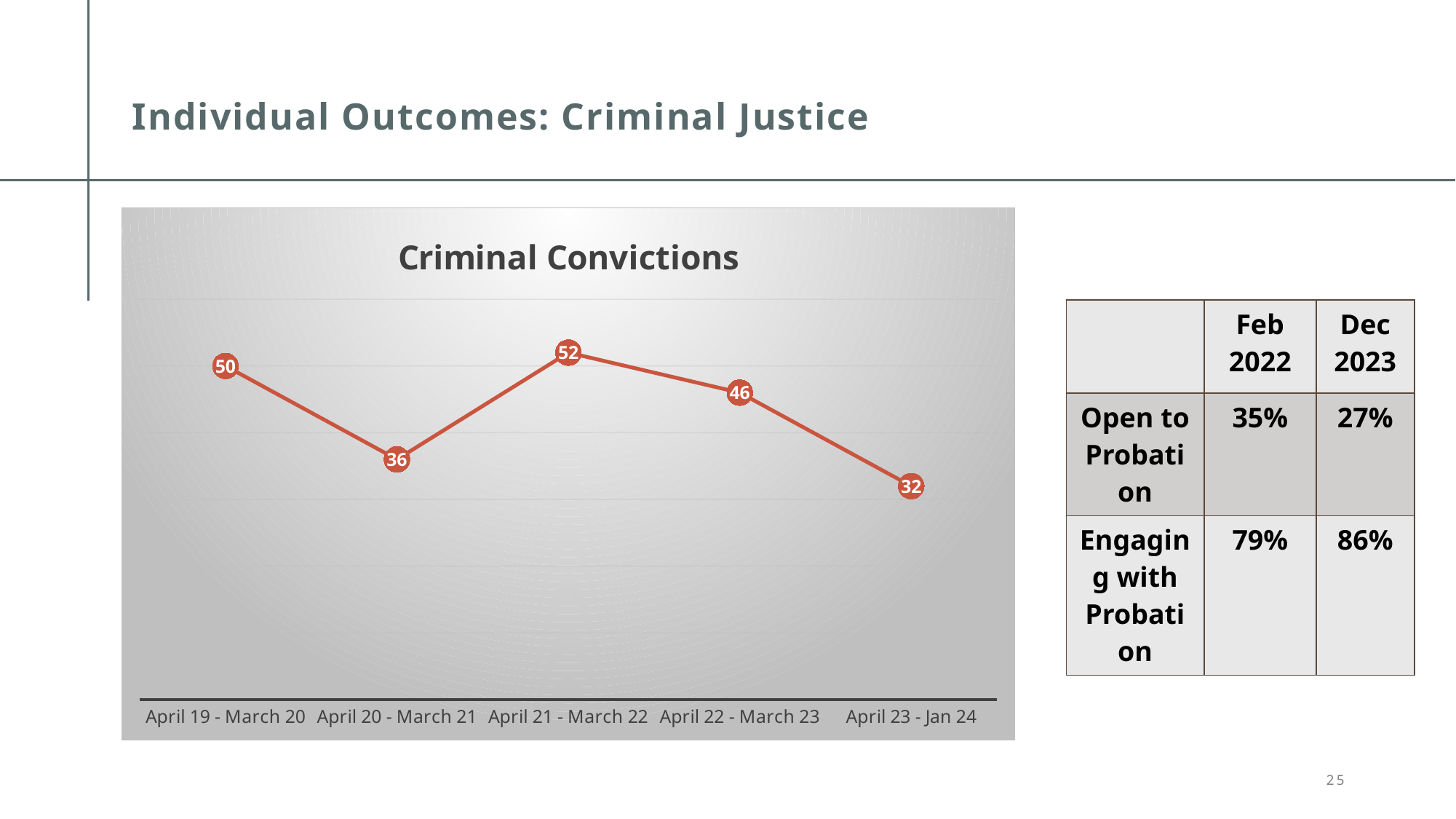
What is the value for April 20 - March 21 in the Criminal Convictions chart? 36 Which is larger in the Criminal Convictions chart: the value for April 19 - March 20 or April 22 - March 23? April 19 - March 20 What kind of chart is the Criminal Convictions chart? Line chart What is the title of the chart on the slide? Criminal Convictions What is the difference between the values for April 19 - March 20 and April 20 - March 21 in the Criminal Convictions chart? 14 What is the value for April 23 - Jan 24 in the Criminal Convictions chart? 32 How many data points are plotted in the Criminal Convictions chart? 5 Does the value in the Criminal Convictions chart rise or fall from April 22 - March 23 to April 23 - Jan 24? Fall What is the difference between the values for April 21 - March 22 and April 22 - March 23 in the Criminal Convictions chart? 6 Which period has the highest value in the Criminal Convictions chart? April 21 - March 22 What is the value for April 19 - March 20 in the Criminal Convictions chart? 50 Which period has the lowest value in the Criminal Convictions chart? April 23 - Jan 24